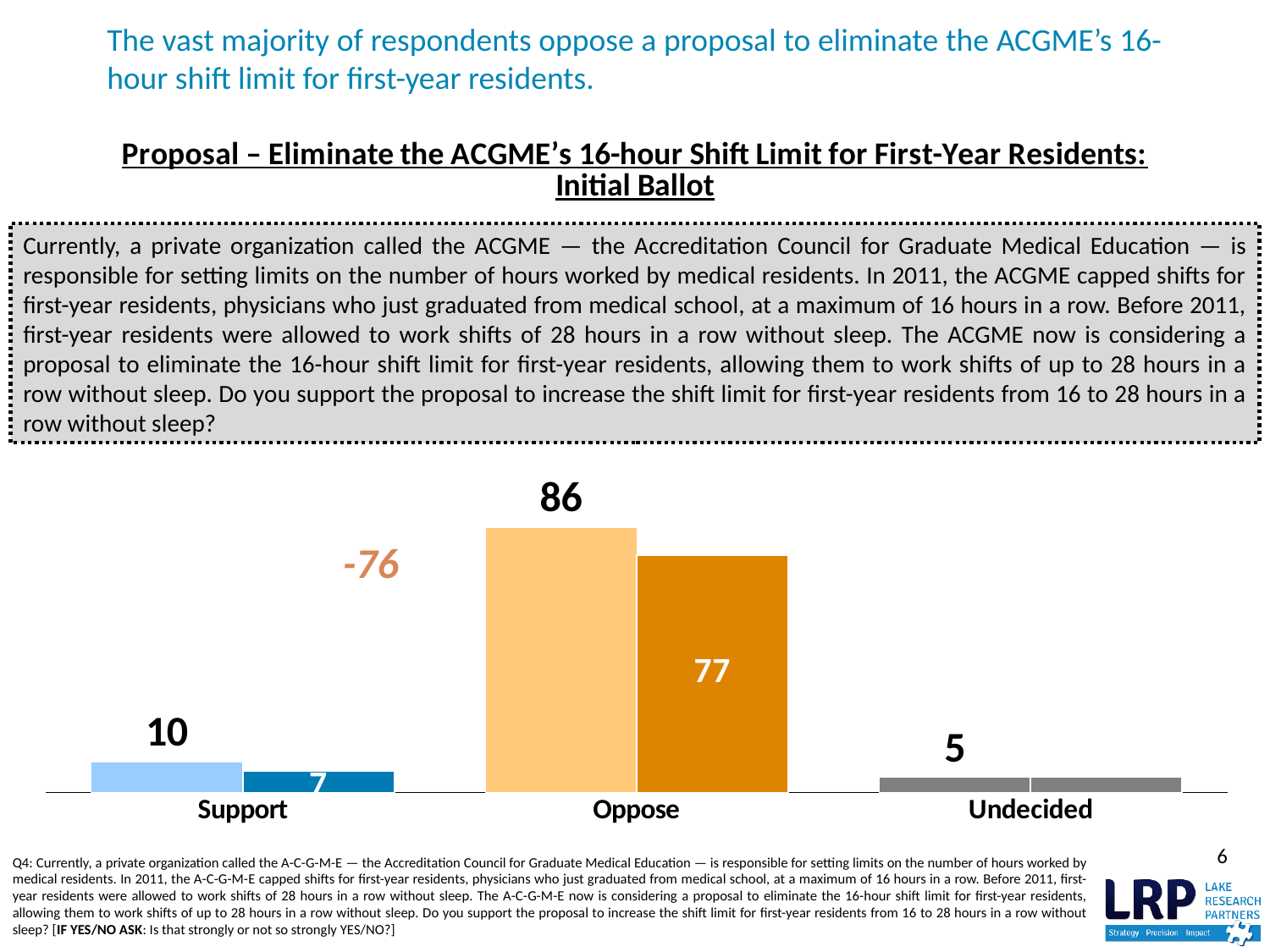
What is the value shown for Undecided? 5 What net figure is printed in italics between the Support and Oppose bars? -76 What is the value shown for Support? 10 Which category has the lowest value? Undecided What value is printed on the darker orange bar in the Oppose category? 77 What value is printed on the darker blue bar in the Support category? 7 What kind of chart is shown on the slide? Bar chart How many categories are shown on the x axis? 3 What is the value shown for Oppose? 86 Which category has the highest value? Oppose What is the difference between the Oppose value (86) and the Support value (10)? 76 Which is larger, the value for Support or the value for Undecided? Support